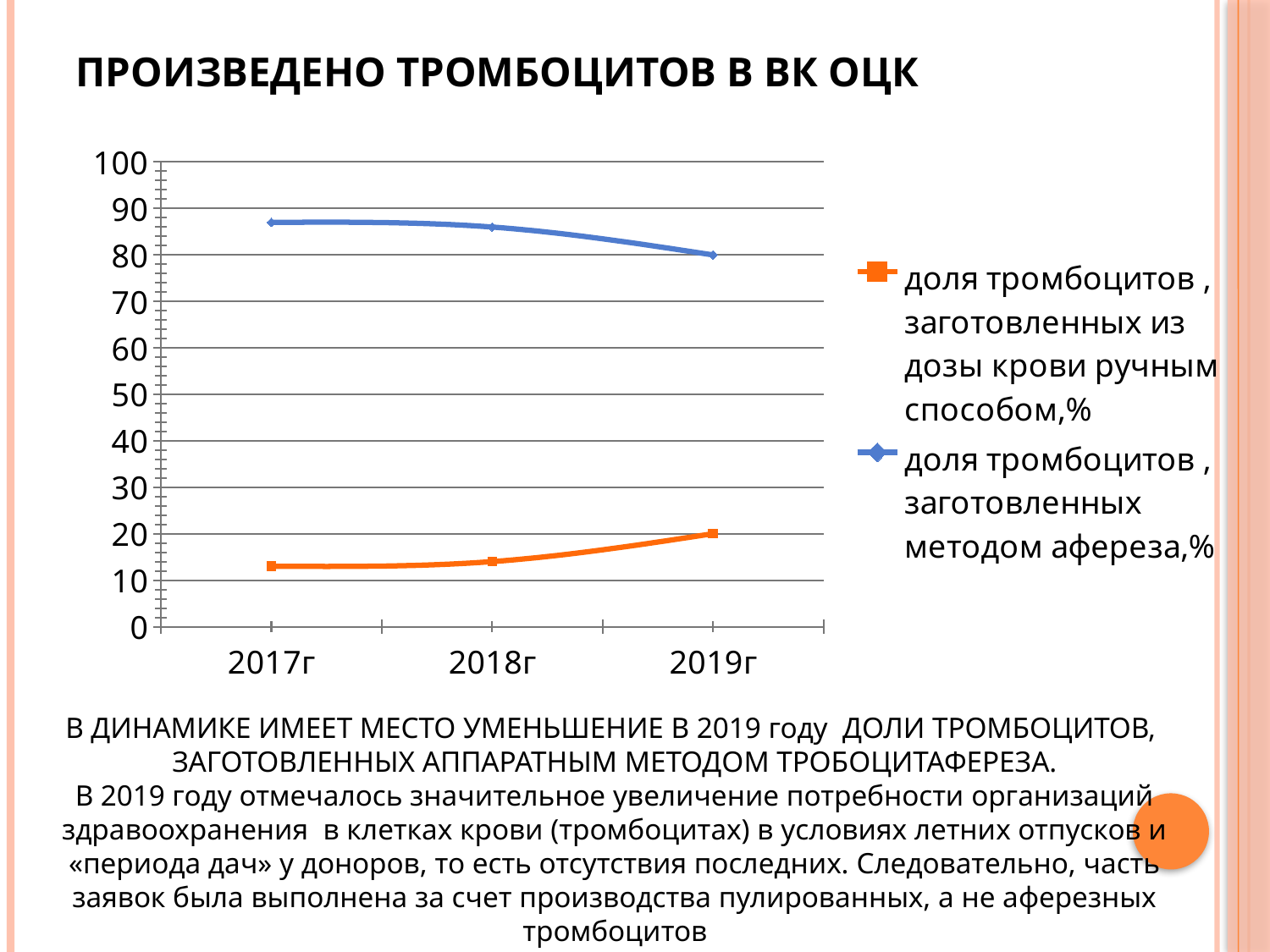
Does the share of platelets prepared manually from blood doses (ручным способом,%) rise or fall from 2017 to 2019? rise In which year is the apheresis series (методом афереза,%) at its highest? 2017г What is the title of the slide containing the chart? ПРОИЗВЕДЕНО ТРОМБОЦИТОВ В ВК ОЦК What colour is the line for the series 'доля тромбоцитов, заготовленных методом афереза,%'? blue In which year is the manual method series (ручным способом,%) at its highest? 2019г What kind of chart is shown on the slide? line chart In 2018, which series has the larger value: the apheresis series or the manual method series? the apheresis series (методом афереза,%) Is the value for the apheresis series (методом афереза,%) in 2017 greater or less than 80? greater How many years are plotted along the x axis? 3 How many series does the legend list? 2 Is the value for the manual method series (ручным способом,%) in 2017 greater or less than 20? less Does the share of platelets prepared by apheresis (доля тромбоцитов, заготовленных методом афереза,%) rise or fall from 2017 to 2019? fall